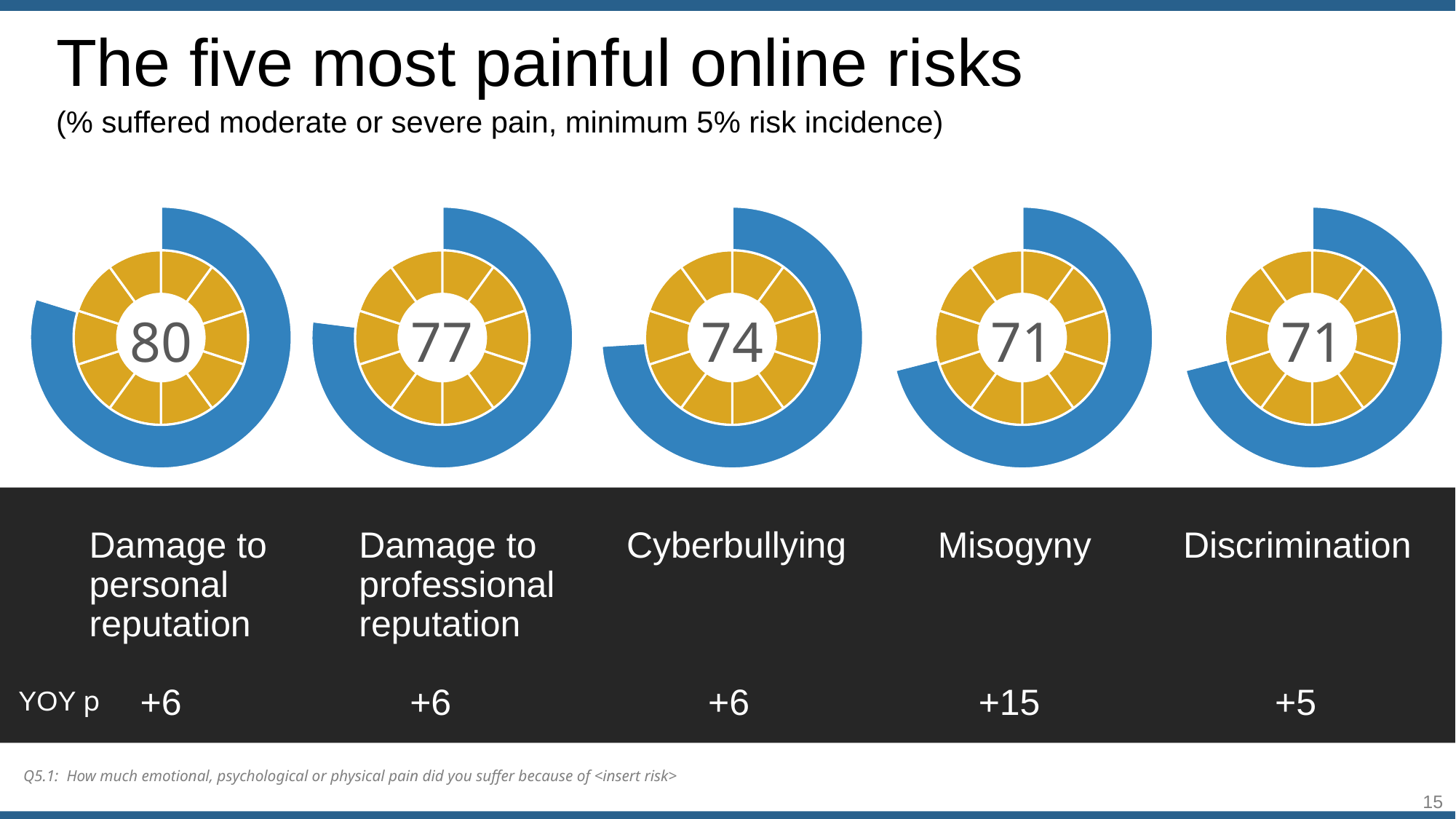
What value is shown for Damage to professional reputation? 77 What is the difference between the values for Cyberbullying and Discrimination? 3 Which has a larger value, Cyberbullying or Misogyny? Cyberbullying Which risk has the largest YOY change? Misogyny How many risks are shown on the slide? 5 What value is shown for Cyberbullying? 74 Which risk has the highest value on the slide? Damage to personal reputation What value is shown for Misogyny? 71 What value is shown for Damage to personal reputation? 80 Do the values rise or fall from left to right across the slide? fall What is the YOY change shown for Misogyny? +15 What is the difference between the values for Damage to personal reputation and Damage to professional reputation? 3